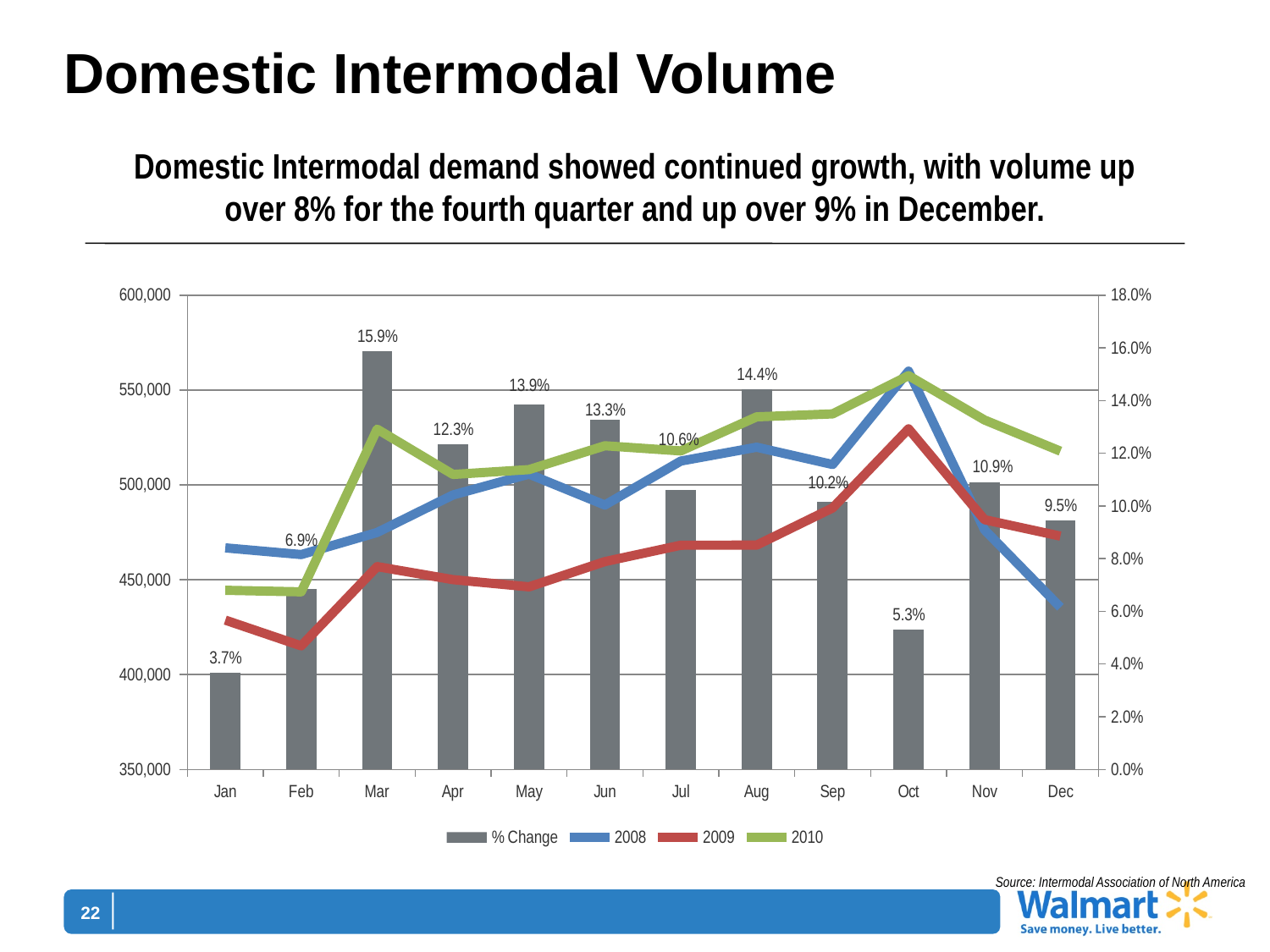
How many series does the legend list? 4 What is the % Change value for December? 9.5% Which month has the highest % Change? Mar How many months are shown on the x axis? 12 Is the 2010 volume for March greater or less than 500,000? greater Which series is drawn as bars rather than lines? % Change Is the 2009 volume for February greater or less than 450,000? less What is the % Change value for October? 5.3% Which month has the lowest % Change? Jan What is the difference between the % Change for August and the % Change for September? 4.2% What is the % Change value for March? 15.9% Which is larger, the % Change for May or the % Change for June? May